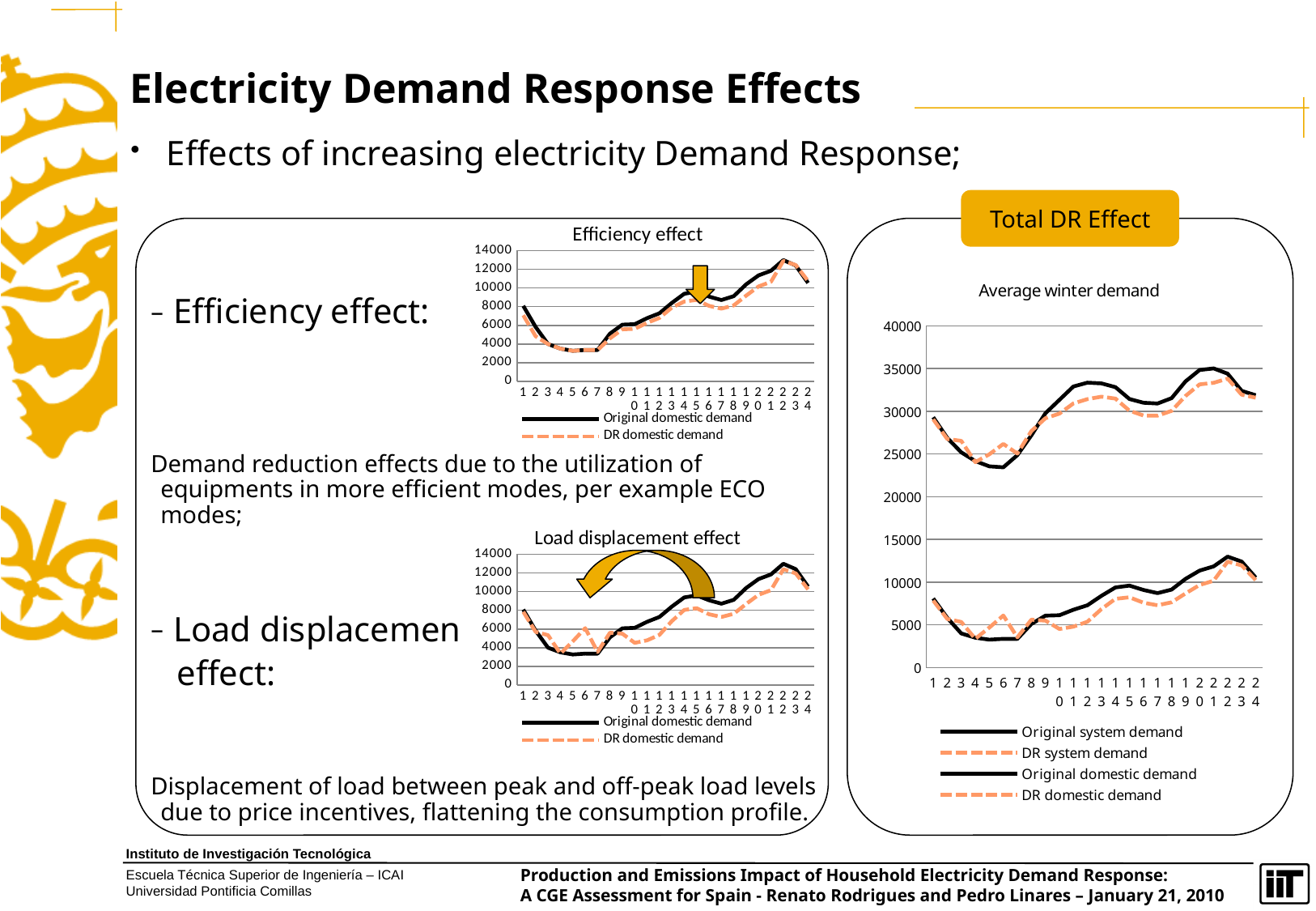
How many points are plotted along the x axis of the "Efficiency effect" chart? 24 In the "Average winter demand" chart, which is larger at point 22: Original system demand or Original domestic demand? Original system demand In the "Efficiency effect" chart, which is larger at point 16: Original domestic demand or DR domestic demand? Original domestic demand In the "Average winter demand" chart, is the value of Original system demand at point 6 greater or less than 25000? less What kind of chart is the "Efficiency effect" chart? line chart In the "Average winter demand" chart, does Original system demand rise or fall from point 1 to point 6? fall In the "Efficiency effect" chart, is the value of Original domestic demand at point 5 greater or less than 4000? less How many series does the legend of the "Average winter demand" chart list? 4 How many series does the legend of the "Load displacement effect" chart list? 2 In the "Efficiency effect" chart, is the value of Original domestic demand at point 22 greater or less than 12000? greater What is the title of the chart on the right side of the slide? Average winter demand